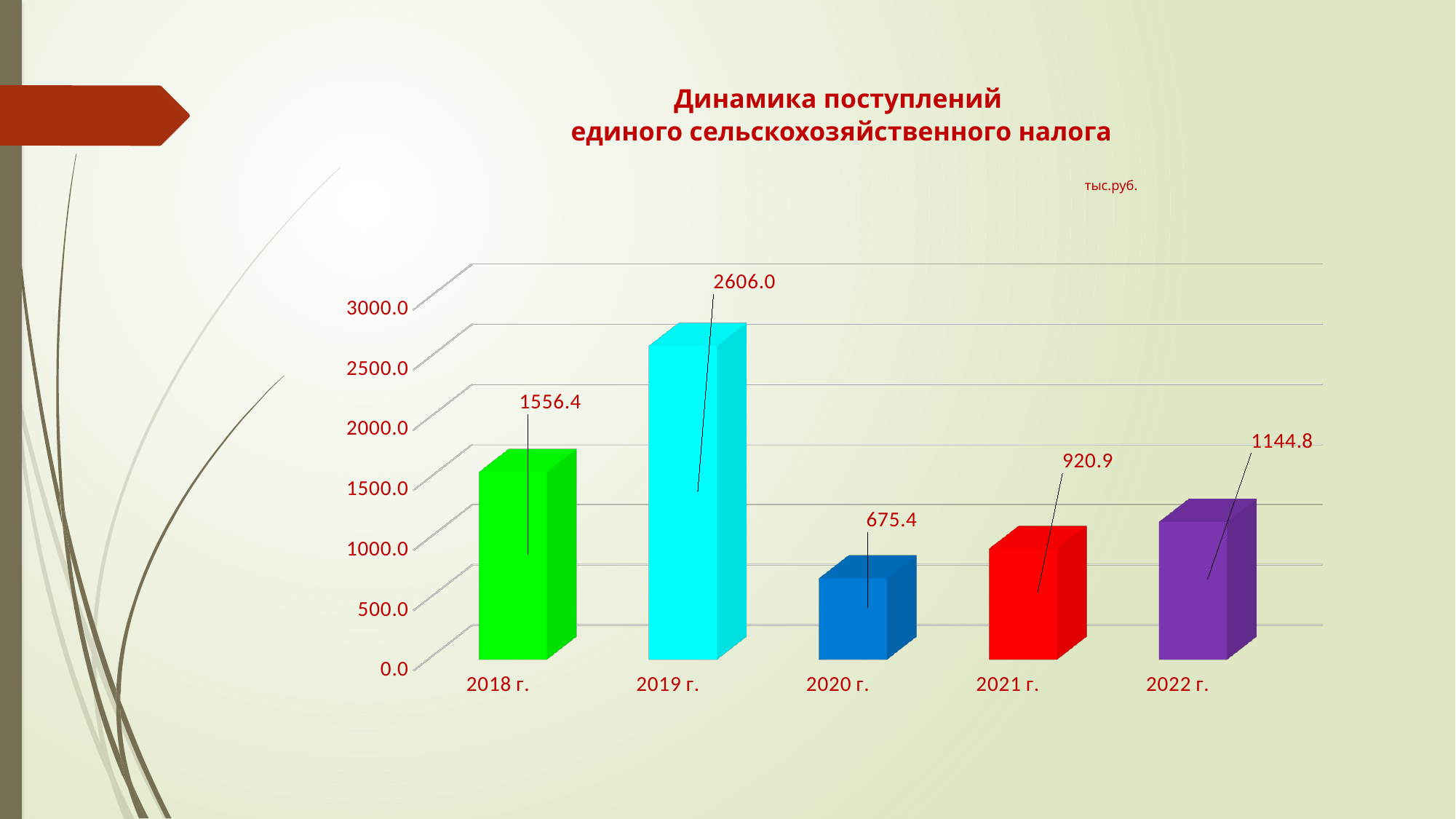
Which year has the lowest value? 2020 г. What unit is indicated for the values on the chart? тыс.руб. Is the value for 2018 г. greater or less than 1000.0? greater Which year has the highest value? 2019 г. What is the difference between the values for 2019 г. and 2018 г.? 1049.6 What is the value for 2020 г.? 675.4 What is the difference between the values for 2022 г. and 2021 г.? 223.9 What kind of chart is shown on the slide? bar chart Which is larger, the value for 2021 г. or the value for 2020 г.? 2021 г. What is the value for 2019 г.? 2606.0 What is the value for 2022 г.? 1144.8 How many years are shown on the chart? 5